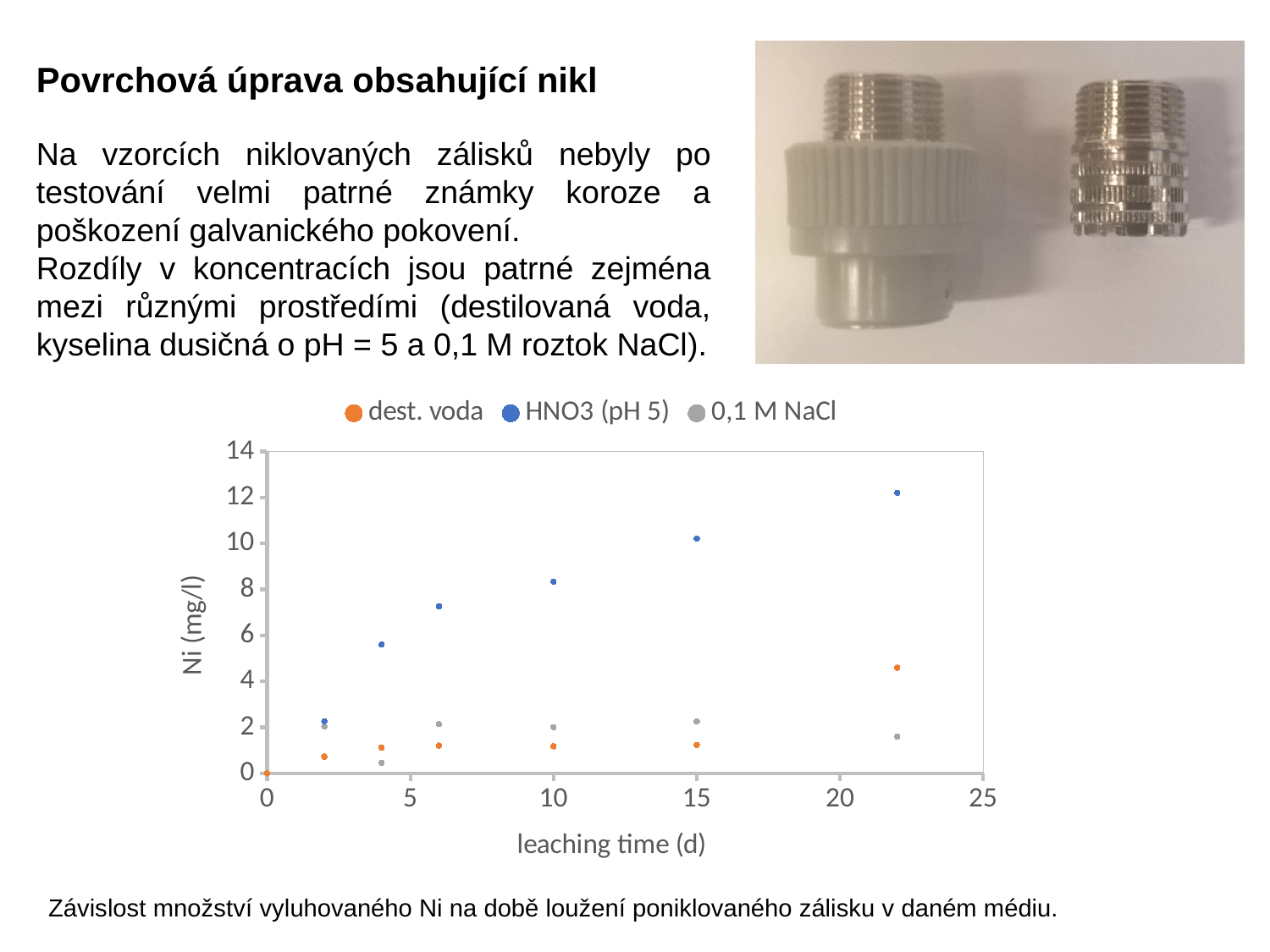
Is the Ni concentration for dest. voda at 22 days greater or less than 4 mg/l? greater At 22 days, which series has the larger Ni concentration, dest. voda or 0,1 M NaCl? dest. voda What kind of chart is shown on the slide? scatter chart Is the Ni concentration for HNO3 (pH 5) at 10 days greater or less than 8 mg/l? greater What is the label of the y axis of the chart? Ni (mg/l) What is the label of the x axis of the chart? leaching time (d) Does the Ni concentration for HNO3 (pH 5) rise or fall as leaching time increases? rise Which series has the highest Ni concentration at 22 days of leaching? HNO3 (pH 5) How many series does the chart legend list? 3 Is the Ni concentration for HNO3 (pH 5) at 6 days greater or less than 8 mg/l? less Which series has the lowest Ni concentration at 22 days of leaching? 0,1 M NaCl